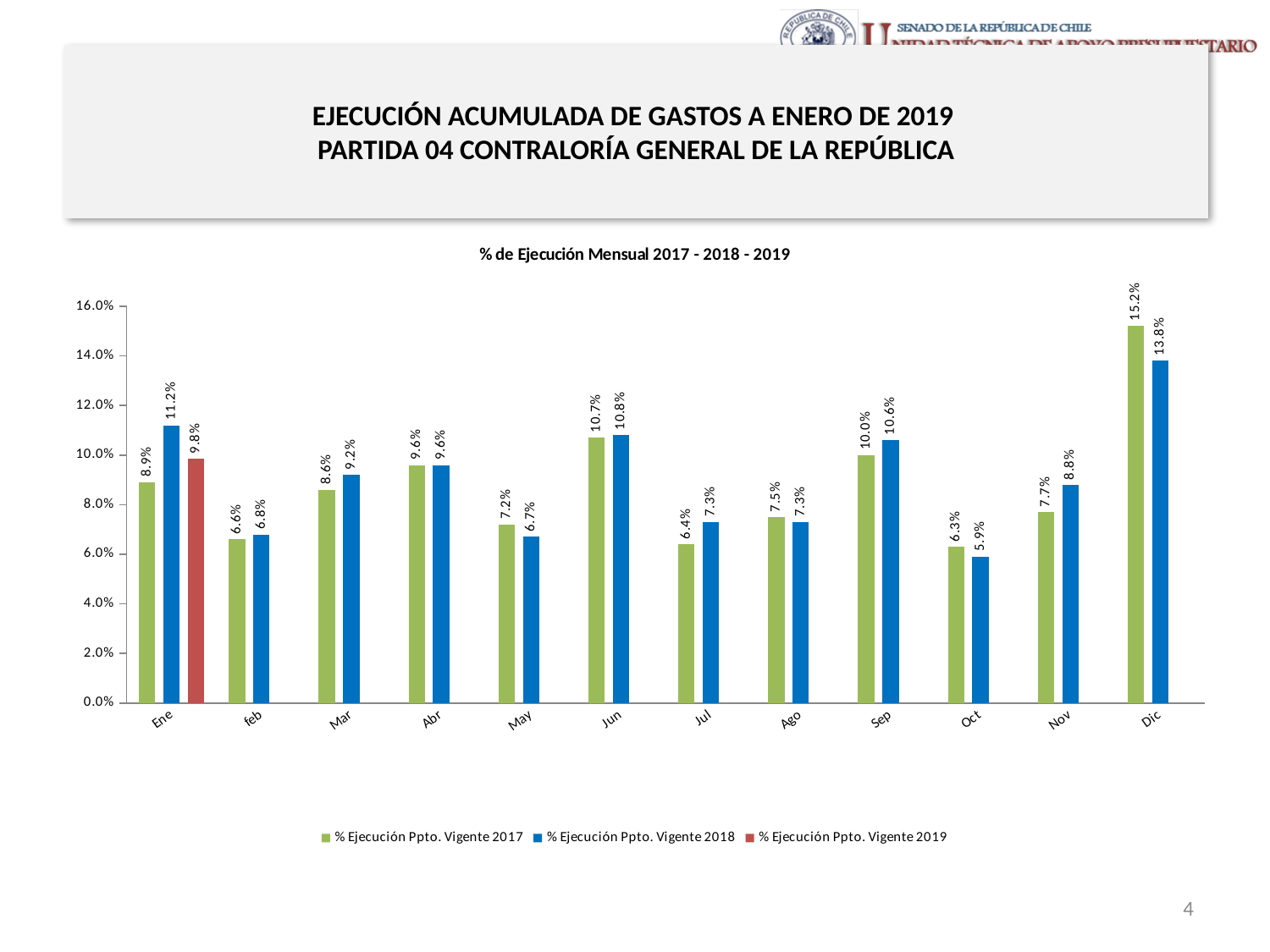
What is the value for Ene in the % Ejecución Ppto. Vigente 2019 series? 9.8% Which is larger for Jul: the 2017 value or the 2018 value? 2018 value (7.3%) What is the value for Dic in the % Ejecución Ppto. Vigente 2017 series? 15.2% What is the title of the chart? % de Ejecución Mensual 2017 - 2018 - 2019 How many months are shown on the x axis? 12 Which month has the lowest value in the % Ejecución Ppto. Vigente 2017 series? Oct Is the value for Sep in the 2018 series greater or less than 10.0%? greater Which month has the highest value in the % Ejecución Ppto. Vigente 2018 series? Dic How many series does the legend list? 3 What is the value for Oct in the % Ejecución Ppto. Vigente 2018 series? 5.9% What kind of chart is shown on the slide? Bar chart What is the difference between the 2018 and 2017 values for Ene? 2.3%